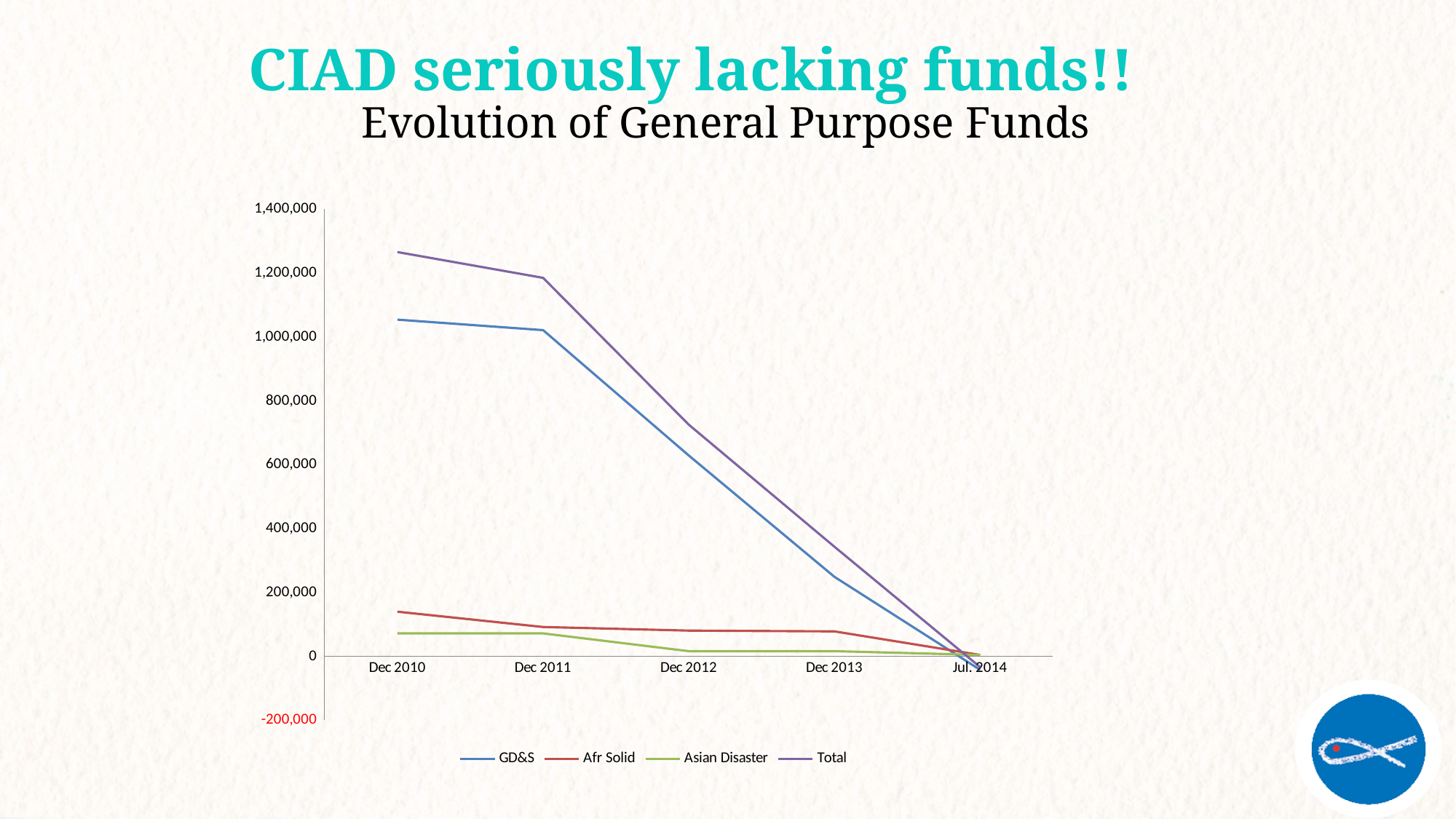
Is the value for GD&S at Dec 2010 greater or less than 1,000,000? greater Is the value for Afr Solid at Dec 2010 greater or less than 200,000? less How many series does the legend list? 4 Which series has the highest value at Dec 2010? Total Which series has the lowest value at Dec 2012? Asian Disaster Does the Total series rise or fall from Dec 2010 to Jul. 2014? fall What kind of chart is shown on the slide? line chart Is the value for Total at Dec 2012 greater or less than 600,000? greater Which is larger at Dec 2011, GD&S or Afr Solid? GD&S How many time points are shown along the x axis? 5 What is the title of the chart? Evolution of General Purpose Funds